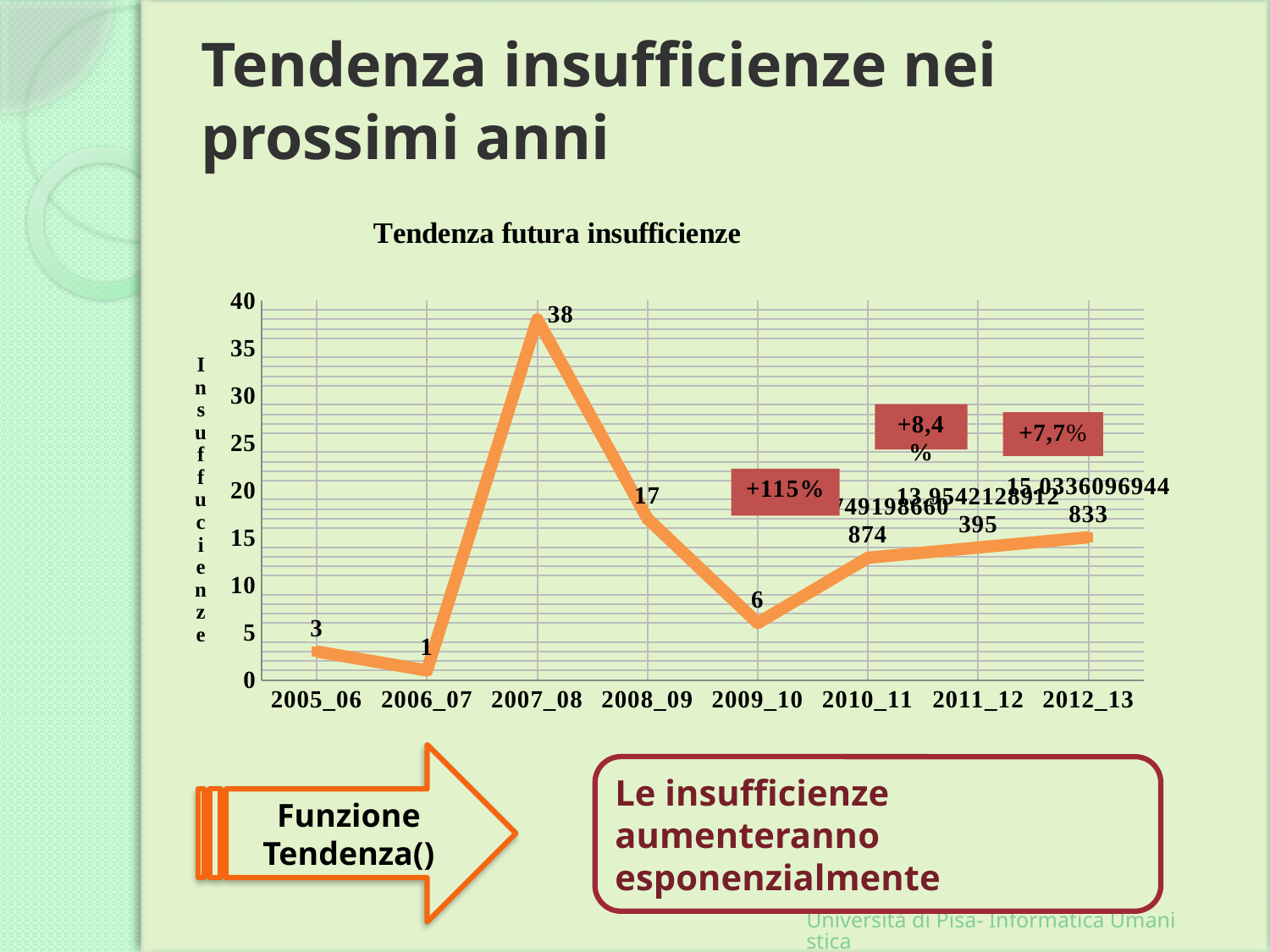
Is the value for 2012_13 greater or less than 20? less What is the difference between the values for 2007_08 and 2008_09? 21 What is the value for 2006_07? 1 What is the value for 2007_08 in the Tendenza futura insufficienze chart? 38 What is the value for 2005_06? 3 How many school years are plotted on the x axis? 8 What is the value for 2008_09? 17 Which school year has the highest value? 2007_08 Which is larger, the value for 2008_09 or the value for 2009_10? 2008_09 What kind of chart is shown on the slide? line chart What is the value for 2009_10? 6 Which school year has the lowest value? 2006_07